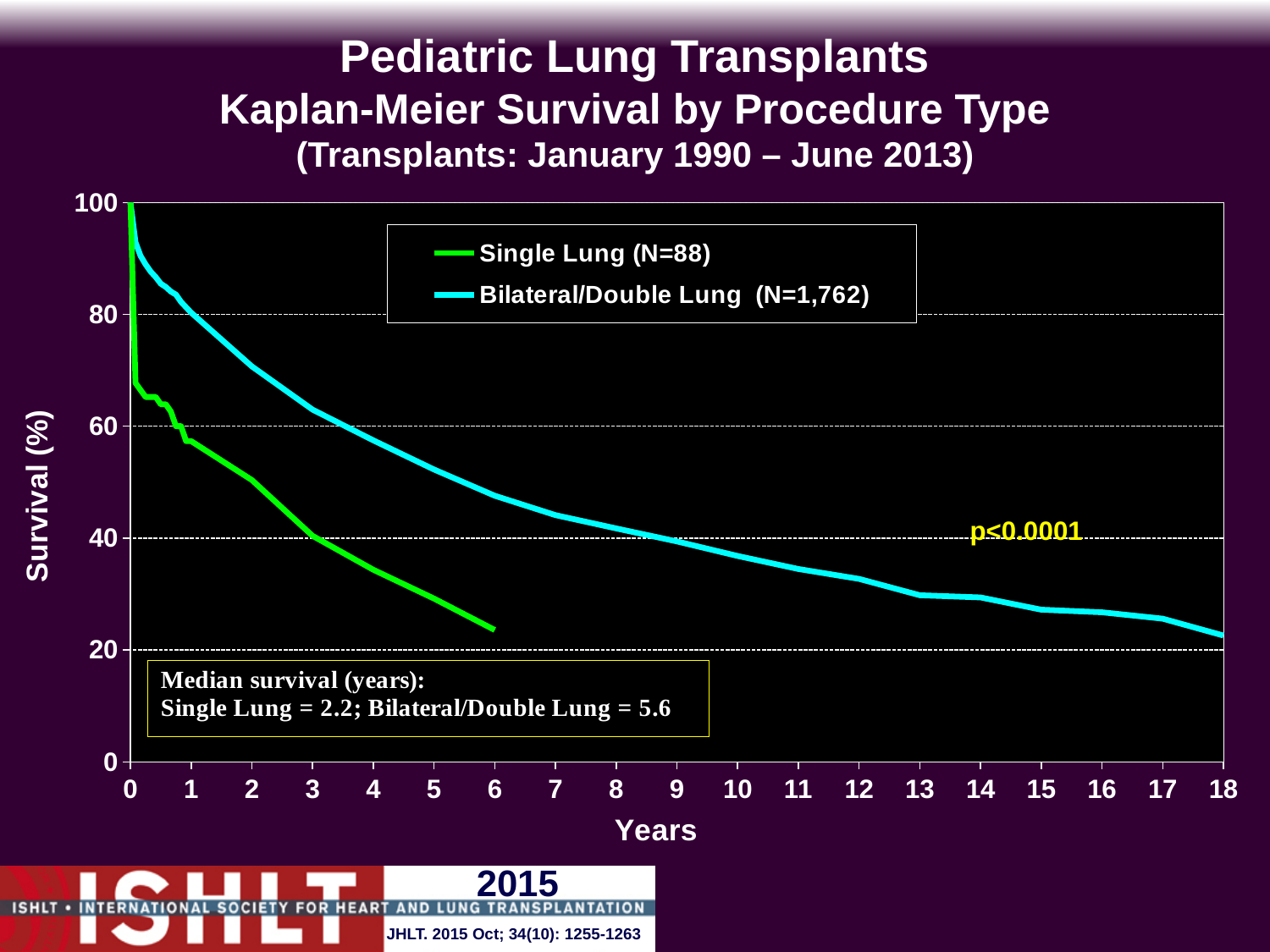
Do the survival curves rise or fall as years increase? Fall What p-value is printed on the chart? p<0.0001 What is the median survival in years for Single Lung transplants? 2.2 Which series has the higher survival at 4 years, Single Lung or Bilateral/Double Lung? Bilateral/Double Lung What kind of chart is shown on the slide? Line chart Is the survival for Bilateral/Double Lung at 2 years greater or less than 60? greater What is the median survival in years for Bilateral/Double Lung transplants? 5.6 How many series does the legend list? 2 Is the survival for Single Lung at 6 years greater or less than 40? less Is the survival for Bilateral/Double Lung at 18 years greater or less than 40? less What is the N for the Bilateral/Double Lung series in the legend? 1,762 What is the N for the Single Lung series in the legend? 88